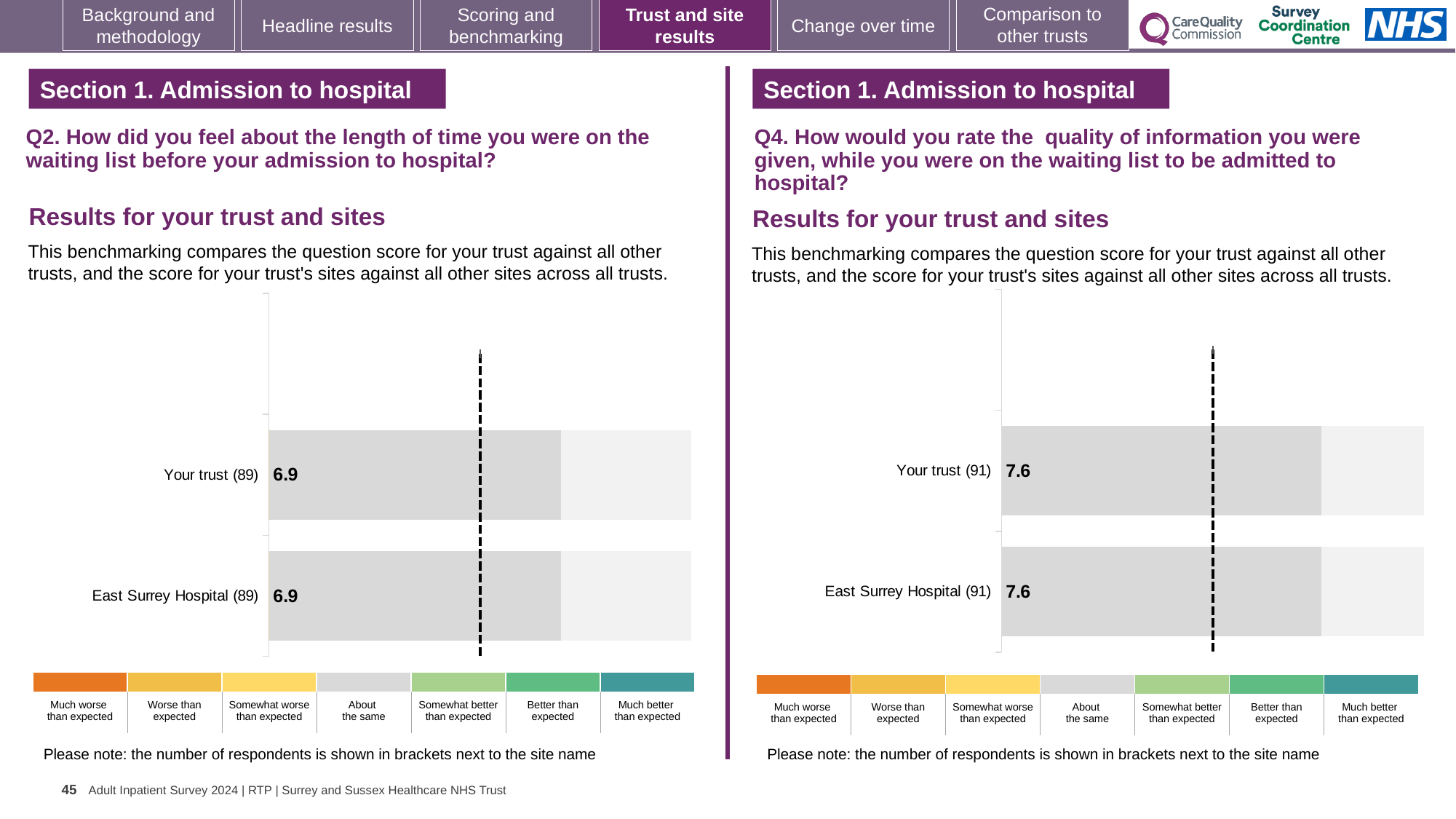
How many rating categories does the colour key below the left chart (Q2) list? 7 On the right chart (Q4), what is the score for East Surrey Hospital? 7.6 On the left chart (Q2), what is the difference between the score for Your trust and the score for East Surrey Hospital? 0 On the left chart (Q2), how many respondents are shown in brackets for East Surrey Hospital? 89 What kind of chart is used on the right side of the slide (Q4)? Bar chart On the right chart (Q4), what is the score for Your trust? 7.6 On the right chart (Q4), what is the difference between the score for Your trust and the score for East Surrey Hospital? 0 In the colour key below the right chart (Q4), which category is shown in orange at the far left? Much worse than expected On the left chart (Q2), what is the score for East Surrey Hospital? 6.9 How many bars are plotted on the left chart (Q2)? 2 On the left chart (Q2), what is the score for Your trust? 6.9 On the right chart (Q4), how many respondents are shown in brackets for Your trust? 91